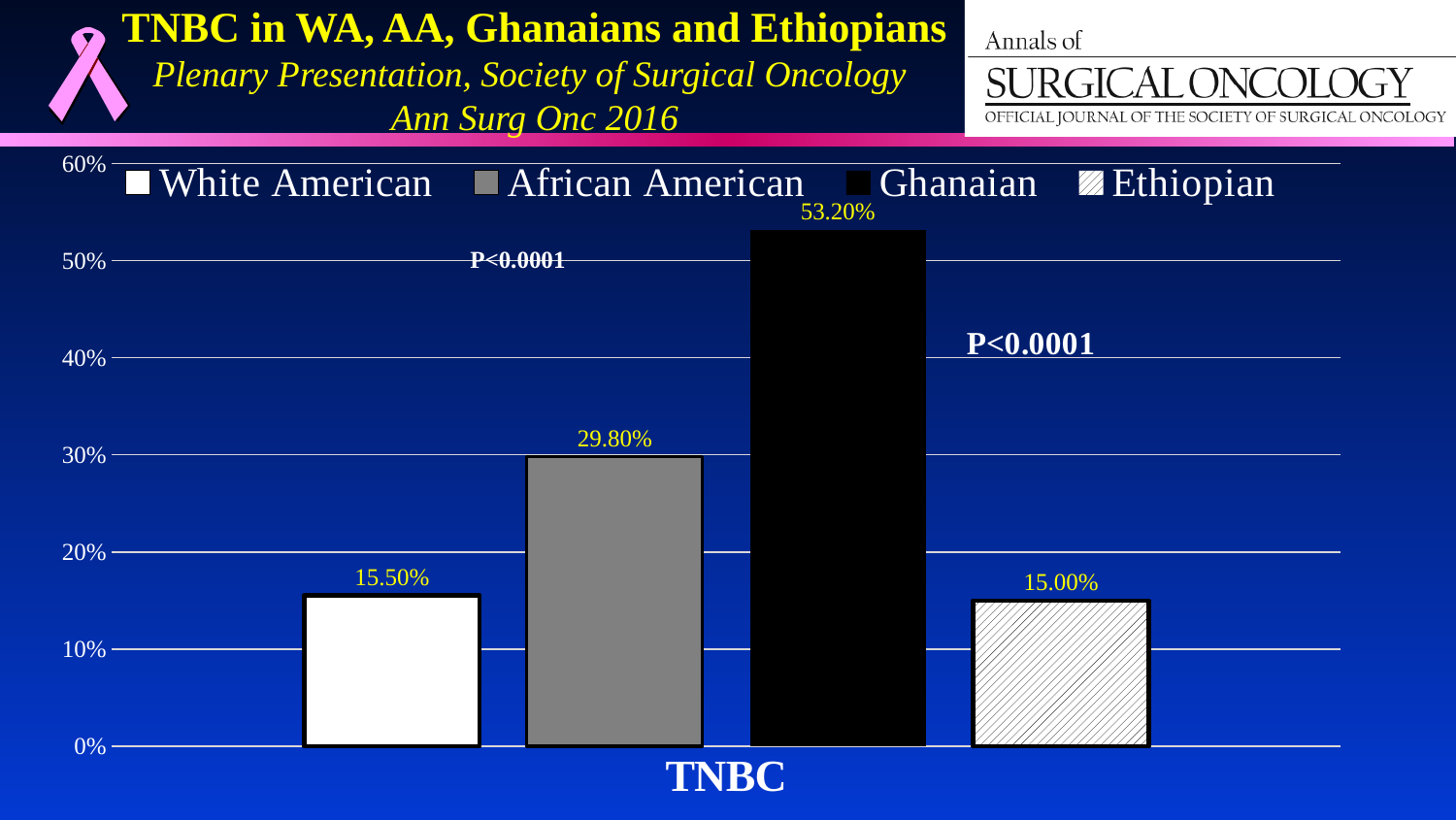
What kind of chart is shown on the slide? bar chart Which group has the highest TNBC value? Ghanaian What is the difference between the Ghanaian and African American TNBC values? 23.40% What is the TNBC value for White American? 15.50% What is the difference between the White American and Ethiopian TNBC values? 0.50% What is the TNBC value for African American? 29.80% Which group has the lowest TNBC value? Ethiopian What is the TNBC value for Ghanaian? 53.20% Is the TNBC value for Ghanaian greater or less than 50%? greater How many series does the legend list? 4 What is the TNBC value for Ethiopian? 15.00% Which is larger, the TNBC value for African American or for White American? African American